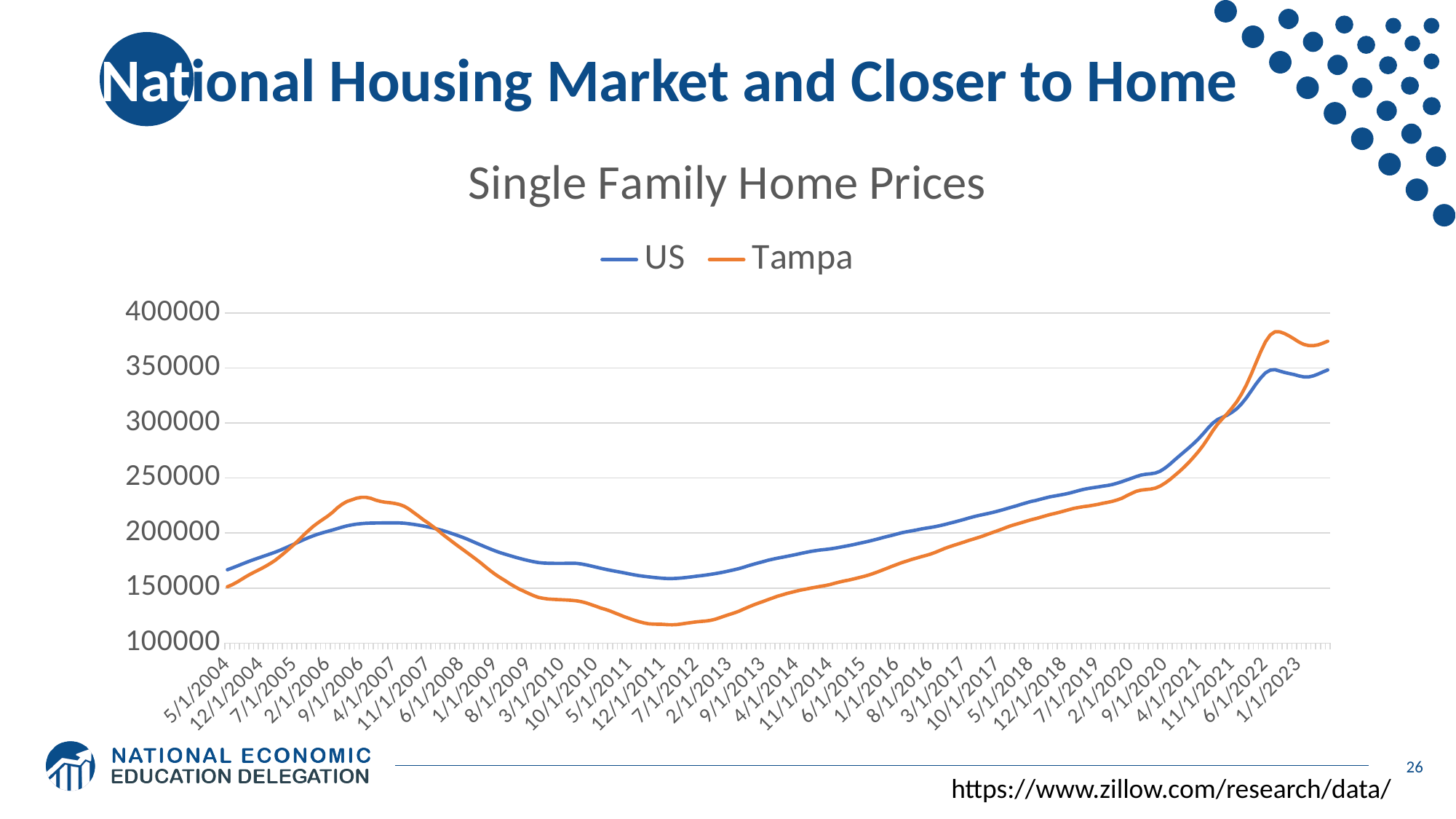
Does the US series rise or fall between 4/1/2007 and 12/1/2011? fall Which series reaches the highest value anywhere on the chart? Tampa Is the Tampa value at 9/1/2006 greater or less than 200000? greater At 12/1/2011, which series has the higher value, US or Tampa? US At 6/1/2022, which series has the higher value, US or Tampa? Tampa How many series does the legend list? 2 Is the Tampa value at 6/1/2022 greater or less than 350000? greater What is the title of the chart? Single Family Home Prices Which series is drawn in orange? Tampa Is the Tampa value at 12/1/2011 greater or less than 150000? less What kind of chart is shown on the slide? line chart